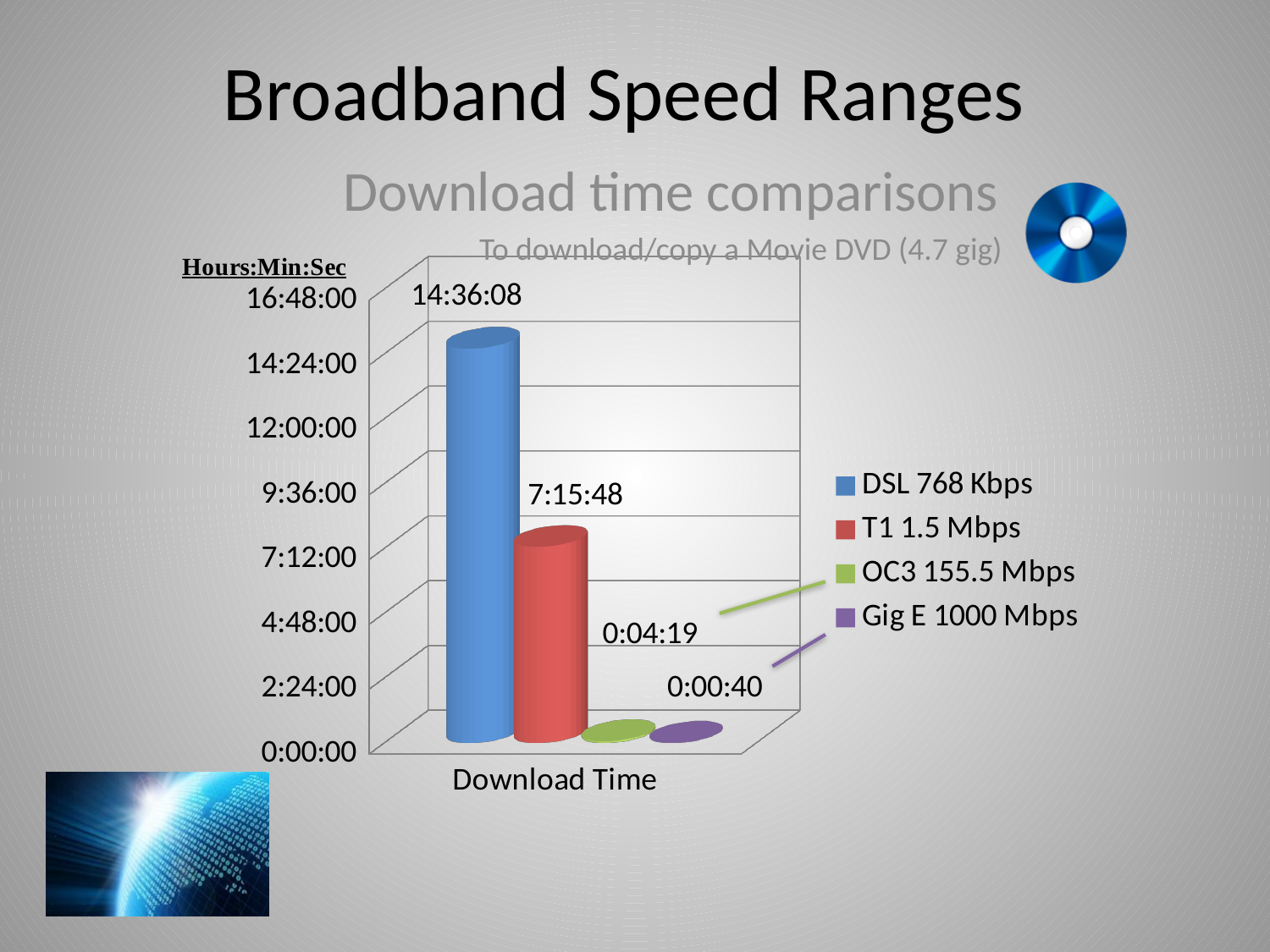
What is the download time shown for Gig E 1000 Mbps? 0:00:40 What is the download time shown for DSL 768 Kbps? 14:36:08 Which connection type has the longest download time? DSL 768 Kbps Which connection type has the shortest download time? Gig E 1000 Mbps Is the download time for T1 1.5 Mbps greater or less than 9:36:00? less Which has a longer download time, T1 1.5 Mbps or OC3 155.5 Mbps? T1 1.5 Mbps Is the download time for DSL 768 Kbps greater or less than 12:00:00? greater What is the title of the chart? Download time comparisons What is the download time shown for T1 1.5 Mbps? 7:15:48 What kind of chart is shown on the slide? Bar chart How many series does the legend list? 4 What is the download time shown for OC3 155.5 Mbps? 0:04:19